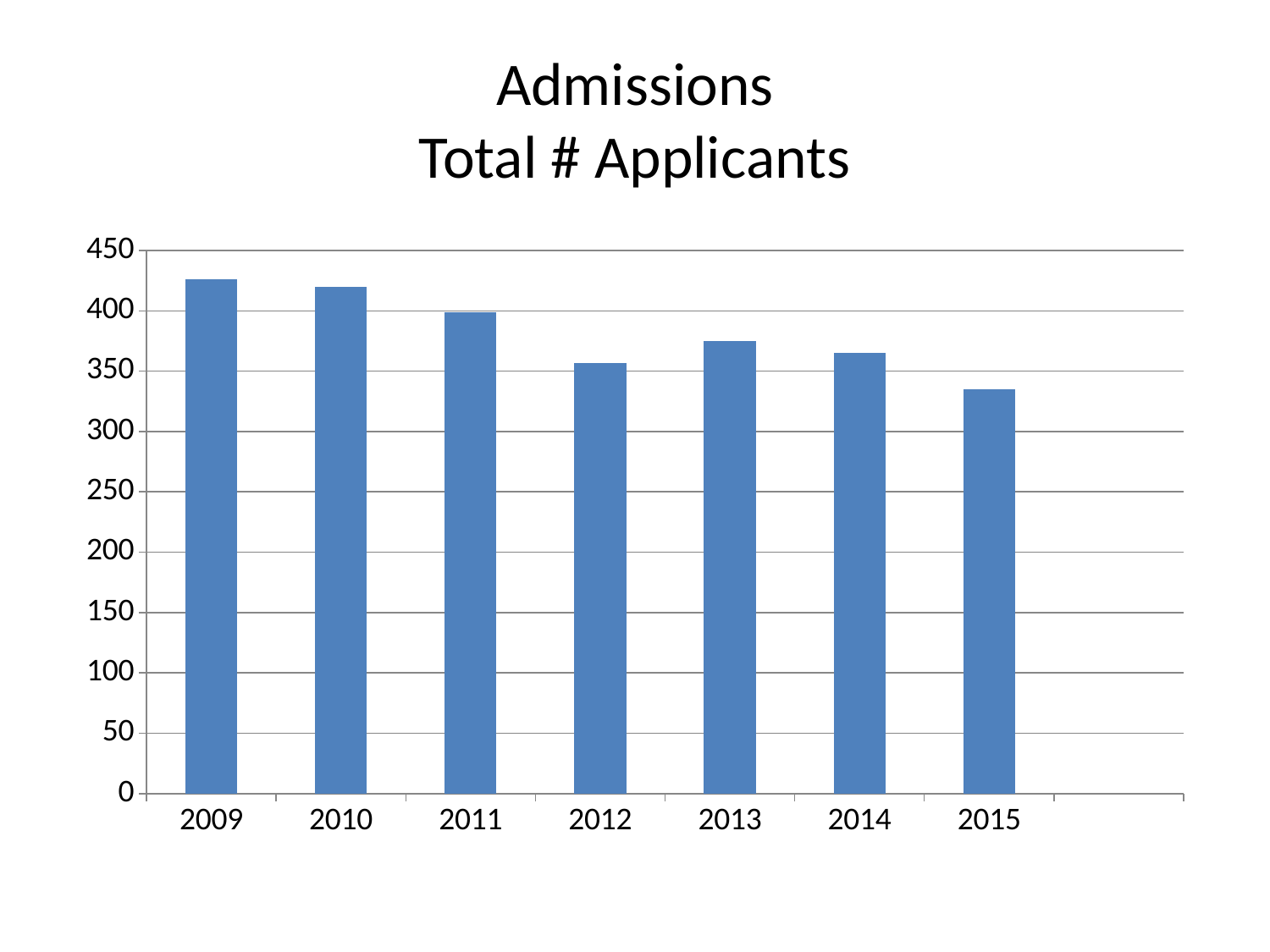
Which year has more applicants, 2011 or 2015? 2011 Is the value for 2013 greater or less than 350? greater Is the value for 2015 greater or less than 350? less How many years are shown on the x axis of the chart? 7 Is the value for 2012 greater or less than 400? less What kind of chart is shown on the slide? bar chart Which year has the lowest total number of applicants? 2015 What is the title of the chart? Admissions Total # Applicants Do the values generally rise or fall from 2009 to 2015? fall Which year has more applicants, 2012 or 2013? 2013